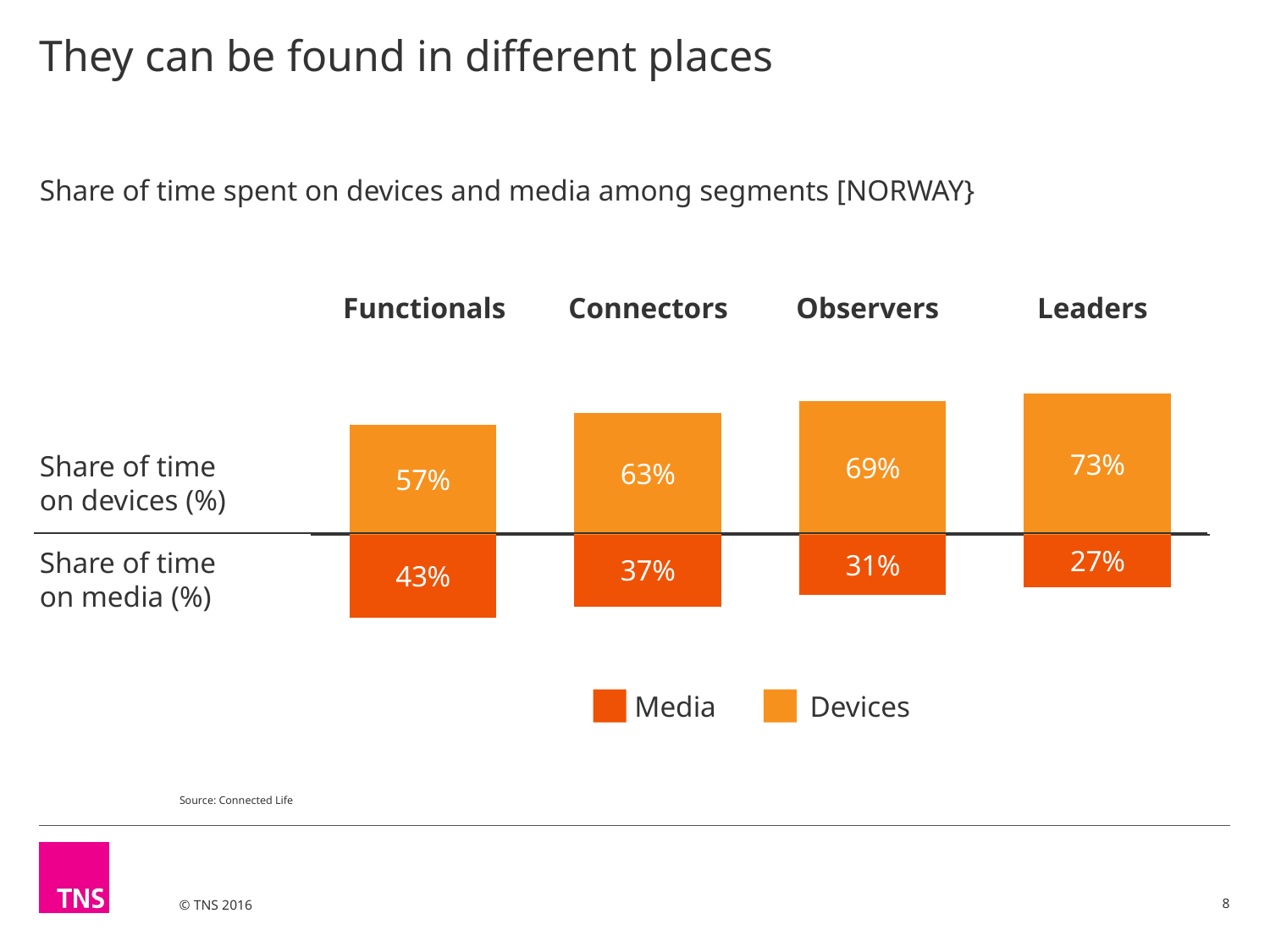
How many series does the legend list? 2 What is the share of time on devices for Leaders? 73% Which segment has the lowest share of time on media? Leaders What is the share of time on devices for Connectors? 63% What is the share of time on media for Functionals? 43% What is the difference between the share of time on devices for Leaders and Functionals? 16 percentage points How many segments are shown in the chart? 4 Which segment has the highest share of time on devices? Leaders What kind of chart is shown on the slide? Bar chart Which is larger for Connectors: share of time on devices or share of time on media? Share of time on devices What is the share of time on media for Observers? 31% Does the share of time on media rise or fall from Functionals to Leaders? Fall